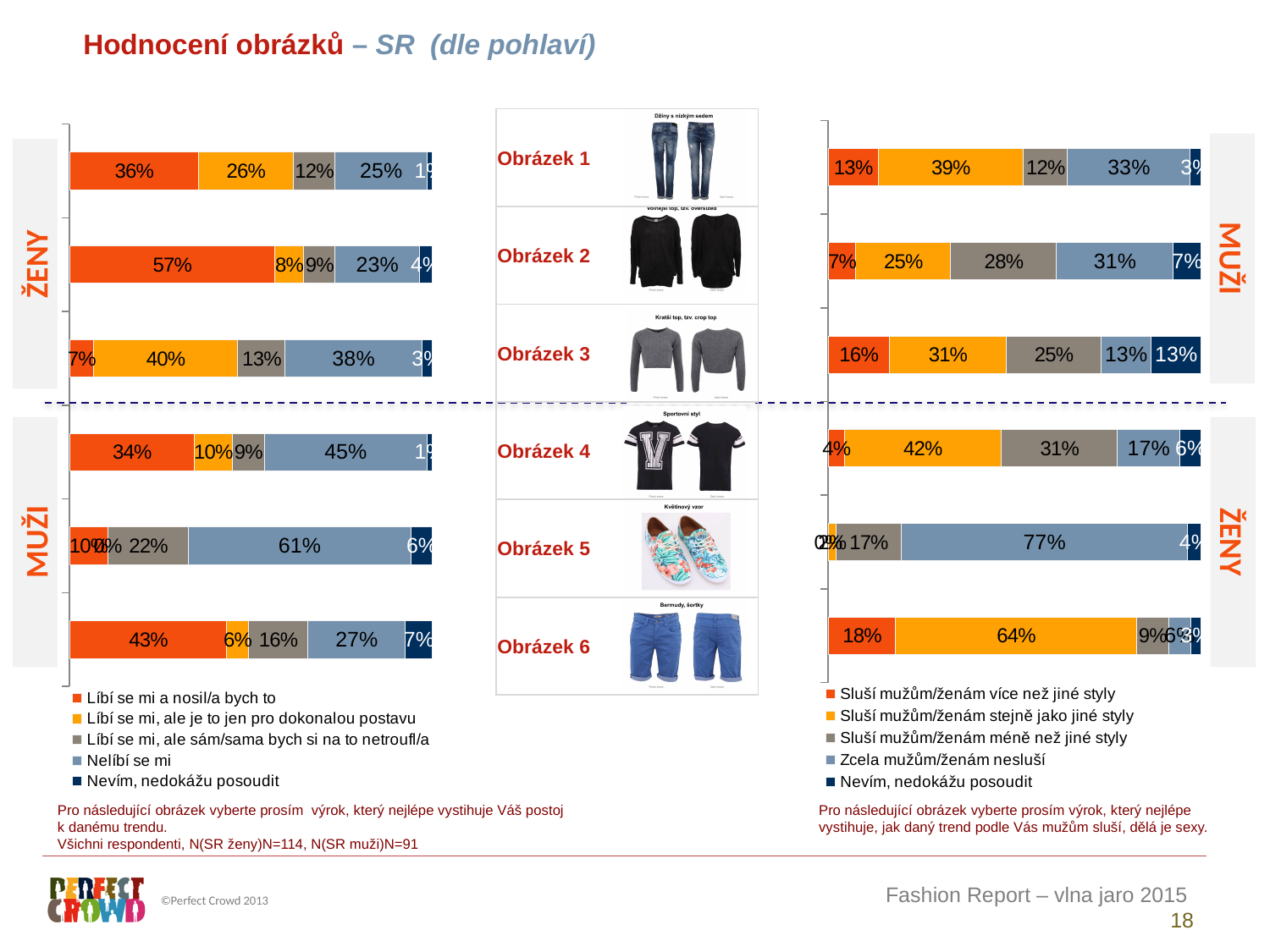
In the right chart, what percentage of women chose 'Sluší mužům/ženám stejně jako jiné styly' for Obrázek 6? 64% In the left chart, among the women's rows, which Obrázek has the highest share for 'Líbí se mi a nosil/a bych to'? Obrázek 2 What type of chart is used on the left side of the slide? Stacked bar chart In the left chart, what is the difference between the 'Líbí se mi a nosil/a bych to' share for Obrázek 6 (men) and Obrázek 4 (men)? 9% In the left chart, among the men's rows, which Obrázek has the highest share for 'Nelíbí se mi'? Obrázek 5 In the left chart, what percentage of men chose 'Nelíbí se mi' for Obrázek 5? 61% How many legend entries does the left chart list? 5 In the right chart, which is larger for Obrázek 2 (men): 'Sluší mužům/ženám méně než jiné styly' or 'Zcela mužům/ženám nesluší'? Zcela mužům/ženám nesluší In the right chart, what is the difference between the 'Sluší mužům/ženám více než jiné styly' share for Obrázek 3 (men) and Obrázek 1 (men)? 3% In the right chart, what percentage of men chose 'Sluší mužům/ženám stejně jako jiné styly' for Obrázek 1? 39% In the left chart, what percentage of women chose 'Líbí se mi a nosil/a bych to' for Obrázek 2? 57% In the right chart, what percentage of women chose 'Zcela mužům/ženám nesluší' for Obrázek 5? 77%